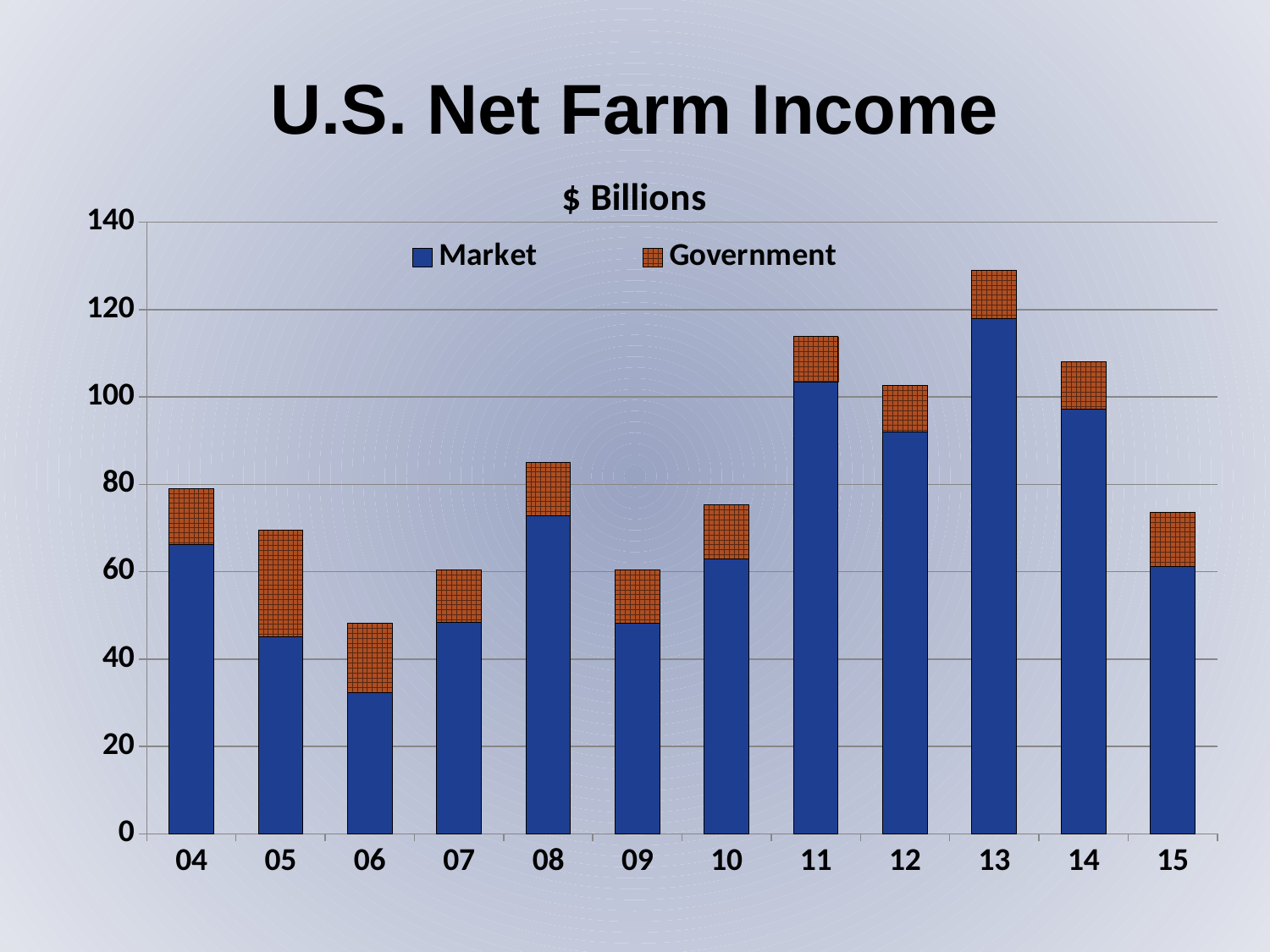
How many years are shown on the x axis? 12 Which year has the lowest total net farm income? 06 Is the total value for 06 greater or less than 60? less Is the Market value for 05 greater or less than 60? less What kind of chart is shown on the slide? Stacked bar chart Which year has the highest total net farm income? 13 Is the Market value for 13 greater or less than 100? greater How many series does the legend list? 2 Which year has the larger total net farm income, 11 or 12? 11 Do the total values rise or fall from 06 to 08? rise Which series is shown in blue in the legend? Market